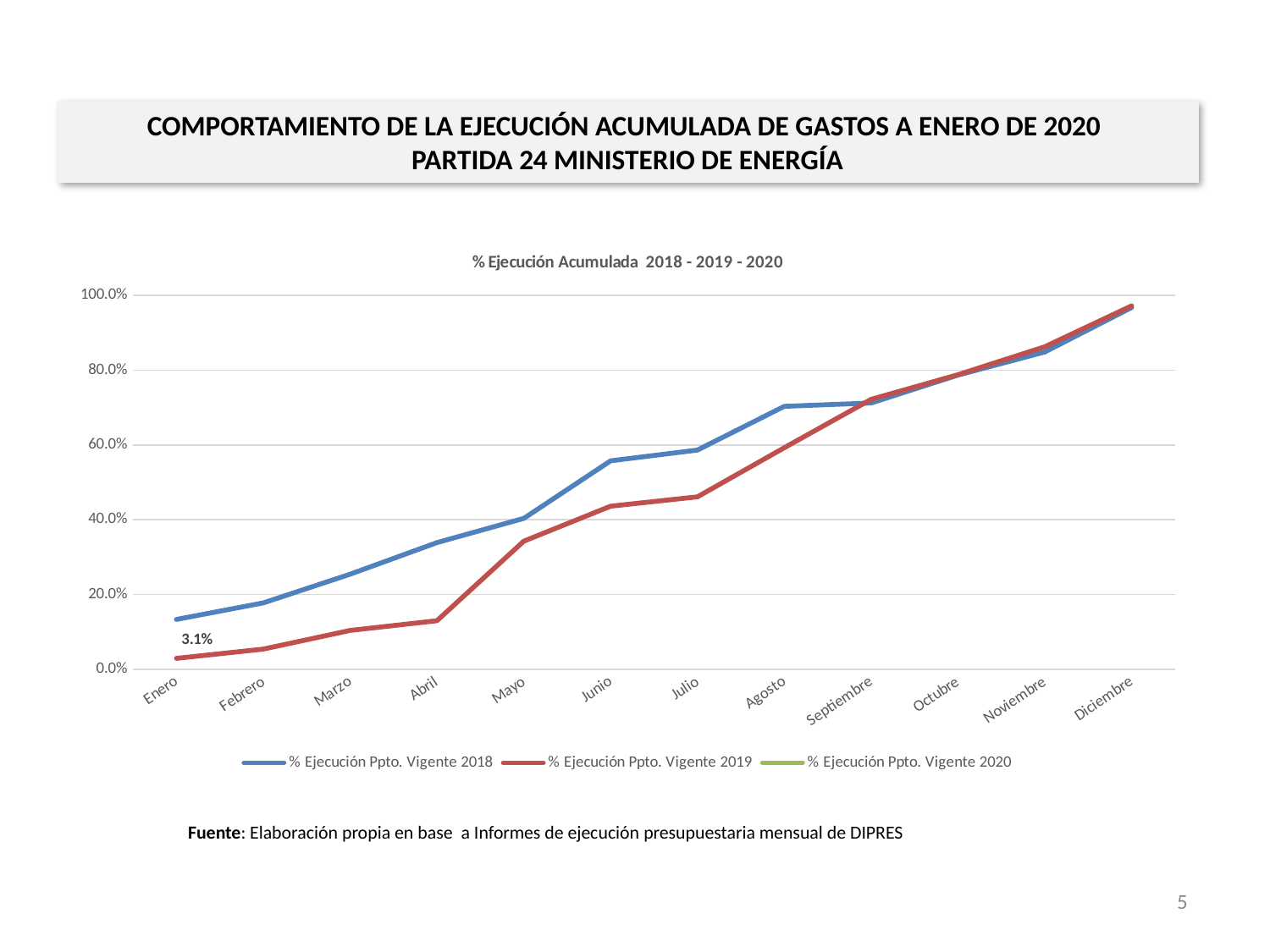
What kind of chart is shown on the slide? line chart Is the value for % Ejecución Ppto. Vigente 2018 in Junio greater or less than 40.0%? greater Is the value for % Ejecución Ppto. Vigente 2019 in Diciembre greater or less than 80.0%? greater Is the value for % Ejecución Ppto. Vigente 2018 in Enero greater or less than 20.0%? less How many series does the chart legend list? 3 In Junio, which series has the higher value: % Ejecución Ppto. Vigente 2018 or % Ejecución Ppto. Vigente 2019? % Ejecución Ppto. Vigente 2018 In Abril, which series has the higher value: % Ejecución Ppto. Vigente 2018 or % Ejecución Ppto. Vigente 2019? % Ejecución Ppto. Vigente 2018 What is the title of the chart? % Ejecución Acumulada 2018 - 2019 - 2020 Which month has the data label 3.1% printed on the chart? Enero Does the % Ejecución Ppto. Vigente 2019 line rise or fall from Enero to Diciembre? rise How many months are shown along the x axis of the chart? 12